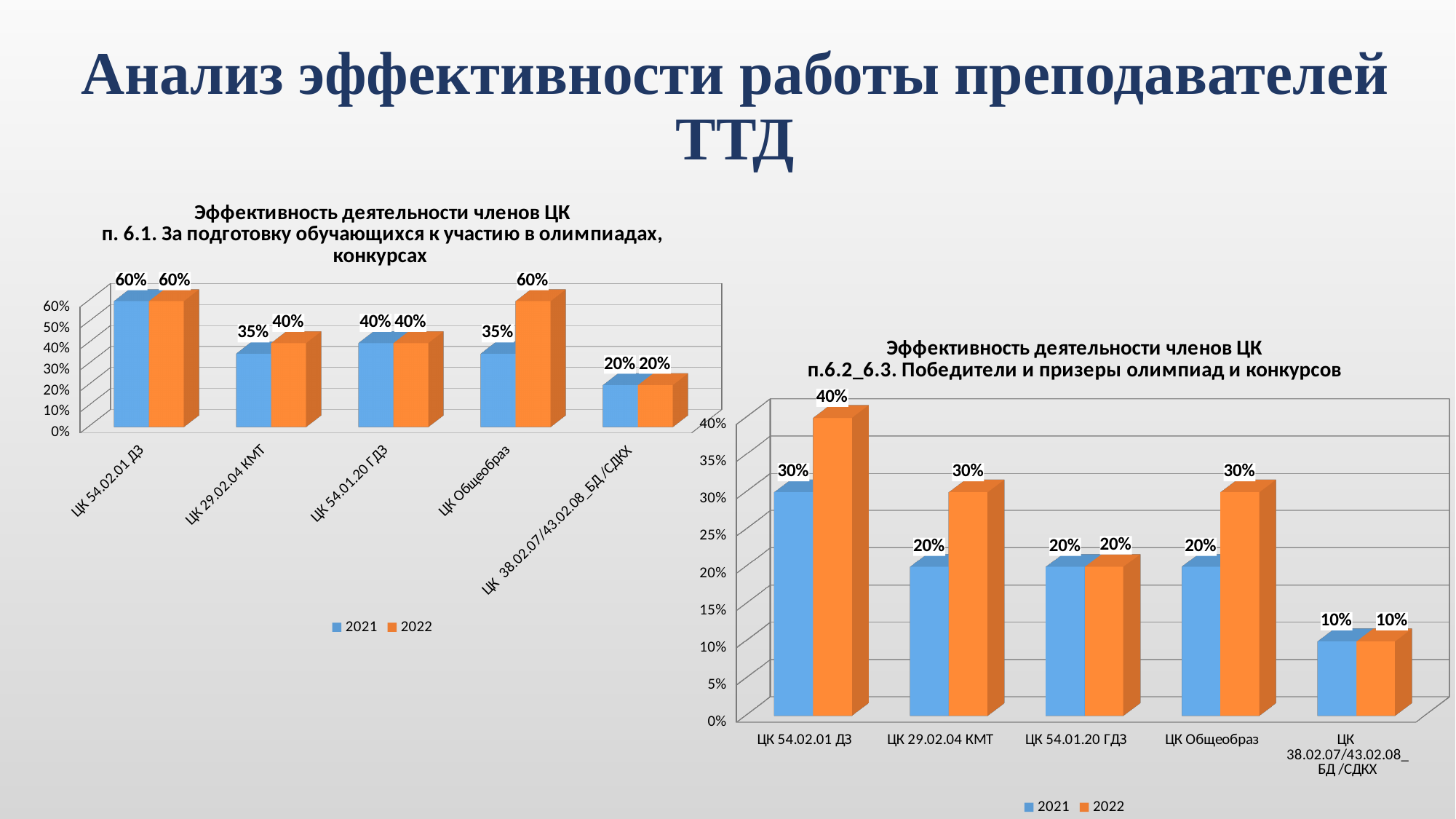
In the left chart (п. 6.1), what is the 2022 value for ЦК Общеобраз? 60% In the right chart (п.6.2_6.3), which is larger for ЦК 29.02.04 КМТ: the 2021 value or the 2022 value? 2022 In the right chart (п.6.2_6.3), what is the 2022 value for ЦК 54.02.01 ДЗ? 40% What type of chart is the left chart (п. 6.1)? Bar chart In the right chart (п.6.2_6.3), which category has the highest 2021 value? ЦК 54.02.01 ДЗ In the left chart (п. 6.1), what is the difference between the 2022 and 2021 values for ЦК Общеобраз? 25% In the right chart (п.6.2_6.3), what is the difference between the 2022 and 2021 values for ЦК 29.02.04 КМТ? 10% How many series does the legend of the right chart (п.6.2_6.3) list? 2 In the left chart (п. 6.1), what is the 2021 value for ЦК 29.02.04 КМТ? 35% In the left chart (п. 6.1), how many categories are shown on the x axis? 5 In the left chart (п. 6.1), which category has the lowest 2022 value? ЦК 38.02.07/43.02.08_БД /СДКХ In the right chart (п.6.2_6.3), what is the 2021 value for ЦК Общеобраз? 20%